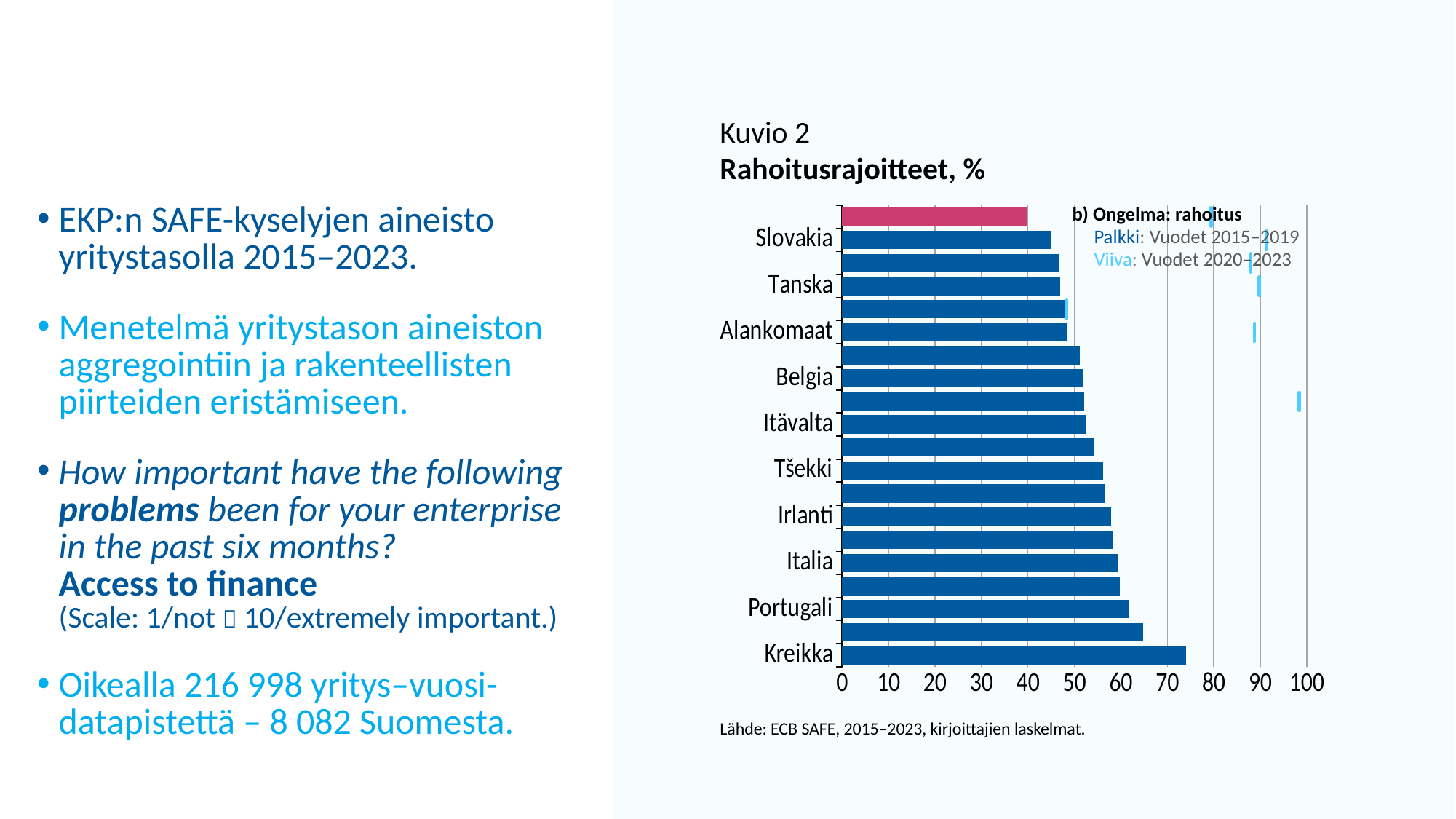
What kind of chart is shown on the slide? bar chart Which labeled country has the longest bar in the chart? Kreikka Which has the larger value, Portugali or Tanska? Portugali According to the chart legend, which years do the bars (Palkki) represent? Vuodet 2015–2019 Is the value for Portugali greater or less than 60? greater Is the value for Belgia greater or less than 50? greater What is the title of the chart (Kuvio 2)? Rahoitusrajoitteet, % Is the value for Kreikka greater or less than 70? greater Which has the larger value, Kreikka or Slovakia? Kreikka How many country names are labeled on the vertical axis of the chart? 10